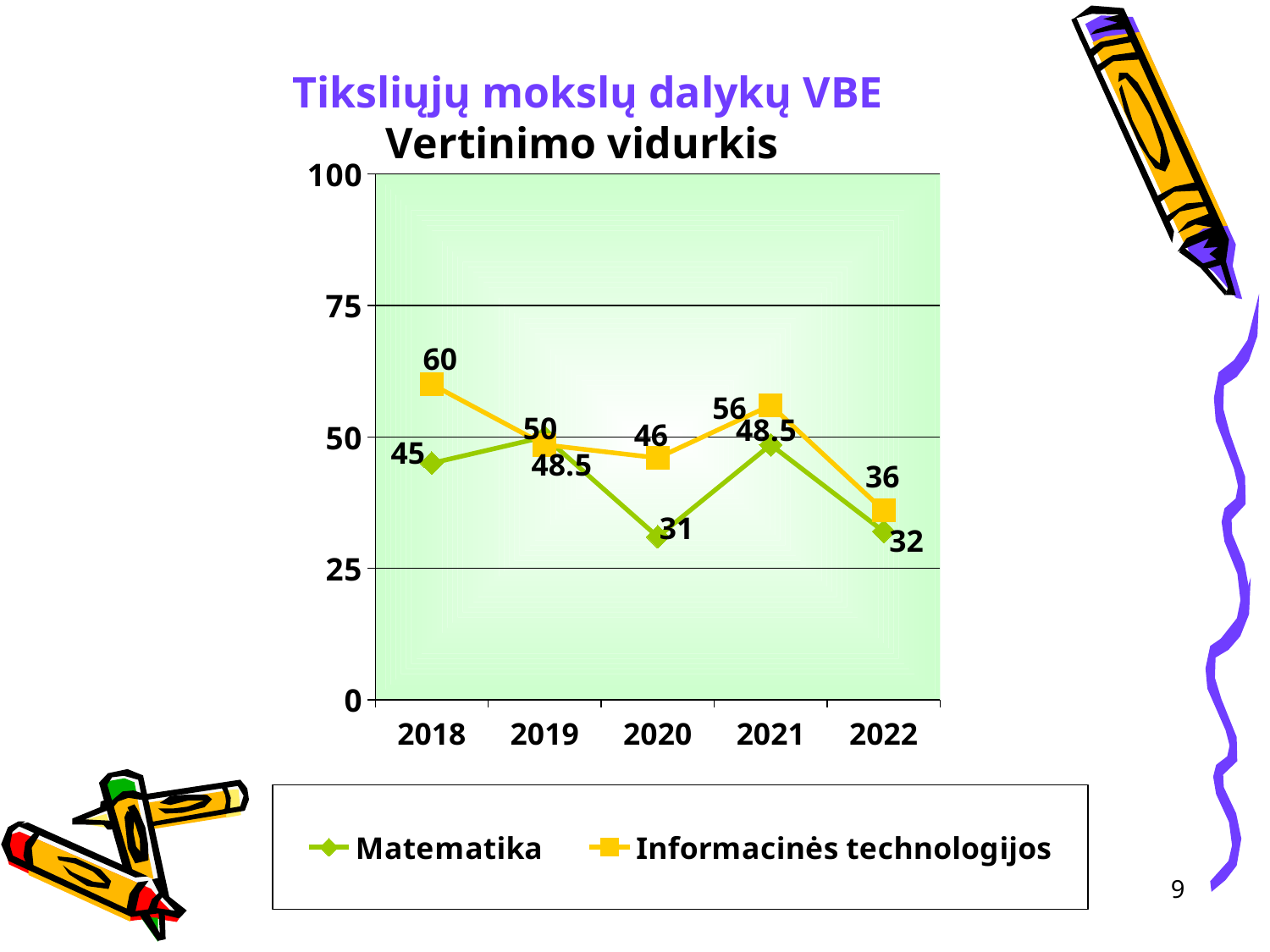
What kind of chart is shown? line chart What is the value for Matematika in 2020? 31 What is the difference between the Informacinės technologijos and Matematika values in 2018? 15 What is the value for Informacinės technologijos in 2022? 36 What is the value for Informacinės technologijos in 2021? 56 How many years are shown on the x axis? 5 What is the title of the chart? Vertinimo vidurkis How many series does the legend list? 2 In which year is the Informacinės technologijos value highest? 2018 What is the value for Matematika in 2018? 45 In which year is the Matematika value lowest? 2020 Which series has the larger value in 2020, Matematika or Informacinės technologijos? Informacinės technologijos